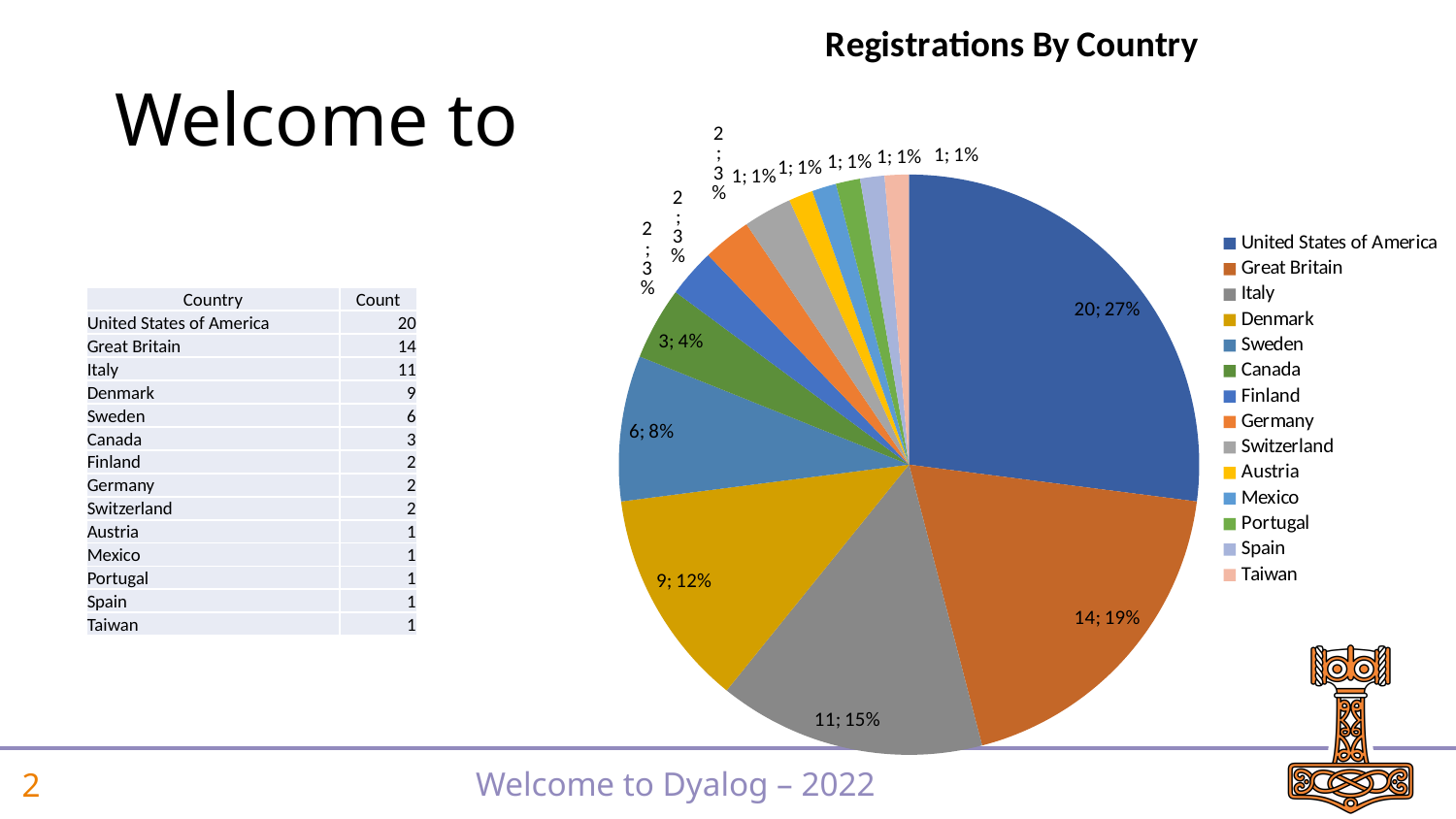
What percentage share of the pie does the United States of America have? 27% What percentage share of the pie does Sweden have? 8% What is the difference between the values for Italy and Denmark? 2 What is the value shown for Great Britain? 14 What kind of chart is shown on the slide? pie chart What percentage share of the pie does Italy have? 15% What is the value shown for Denmark? 9 How many countries does the chart's legend list? 14 Which is larger, the value for Sweden or the value for Canada? Sweden What is the difference between the values for the United States of America and Great Britain? 6 What is the title of the chart? Registrations By Country Which country has the largest slice of the pie? United States of America